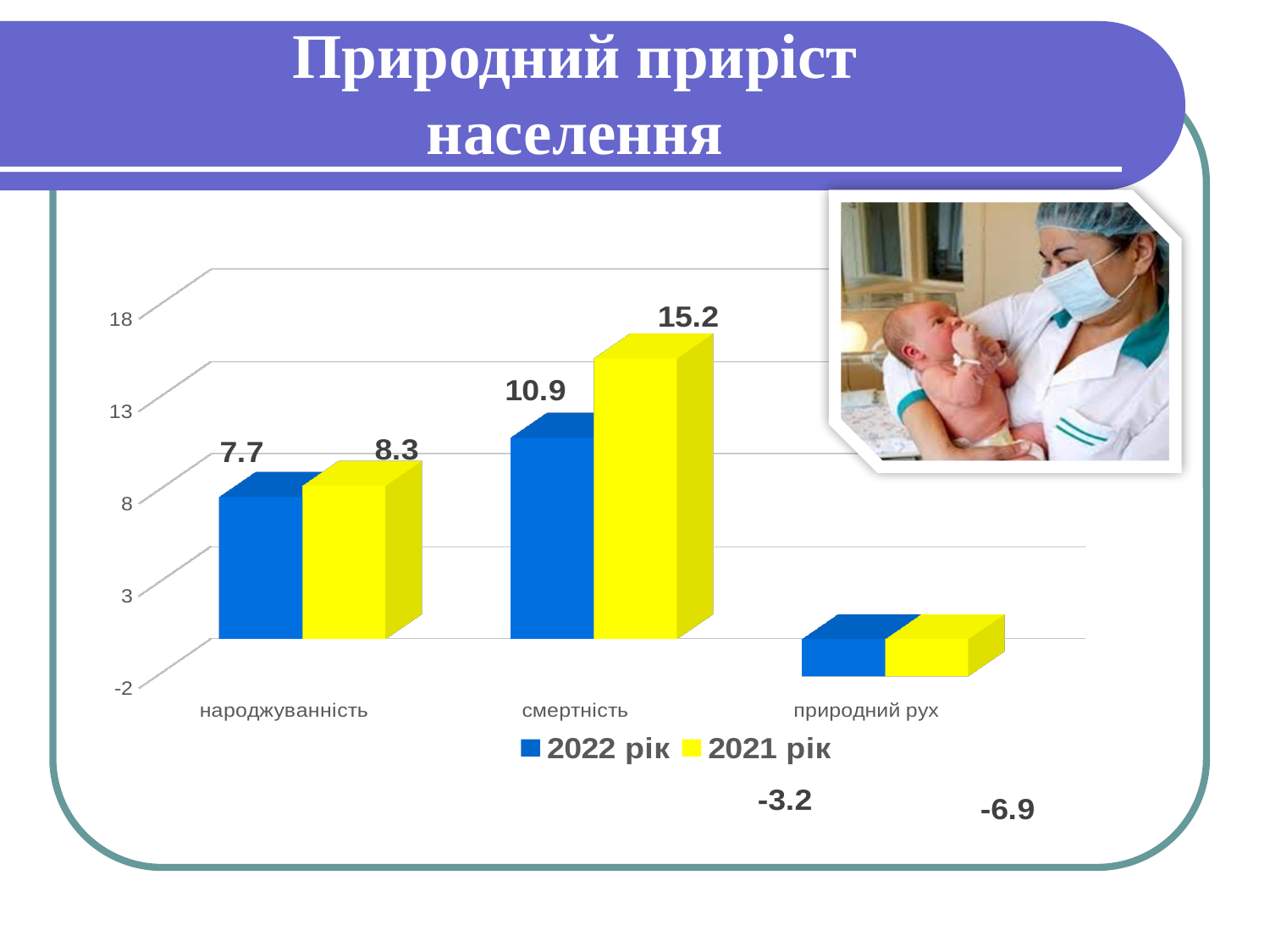
What is the difference between the 2021 рік and 2022 рік values for смертність? 4.3 Which colour represents the 2022 рік series? blue What is the value for народжуваність in the 2022 рік series? 7.7 Which category has the highest value in the 2021 рік series? смертність What is the value for природний рух in the 2021 рік series? -6.9 What is the value for смертність in the 2021 рік series? 15.2 What is the value for природний рух in the 2022 рік series? -3.2 How many series does the legend list? 2 How many categories are shown on the x axis? 3 Which category has the lowest value in the 2022 рік series? природний рух What kind of chart is shown on the slide? bar chart Which is larger for народжуваність: the 2022 рік value or the 2021 рік value? 2021 рік